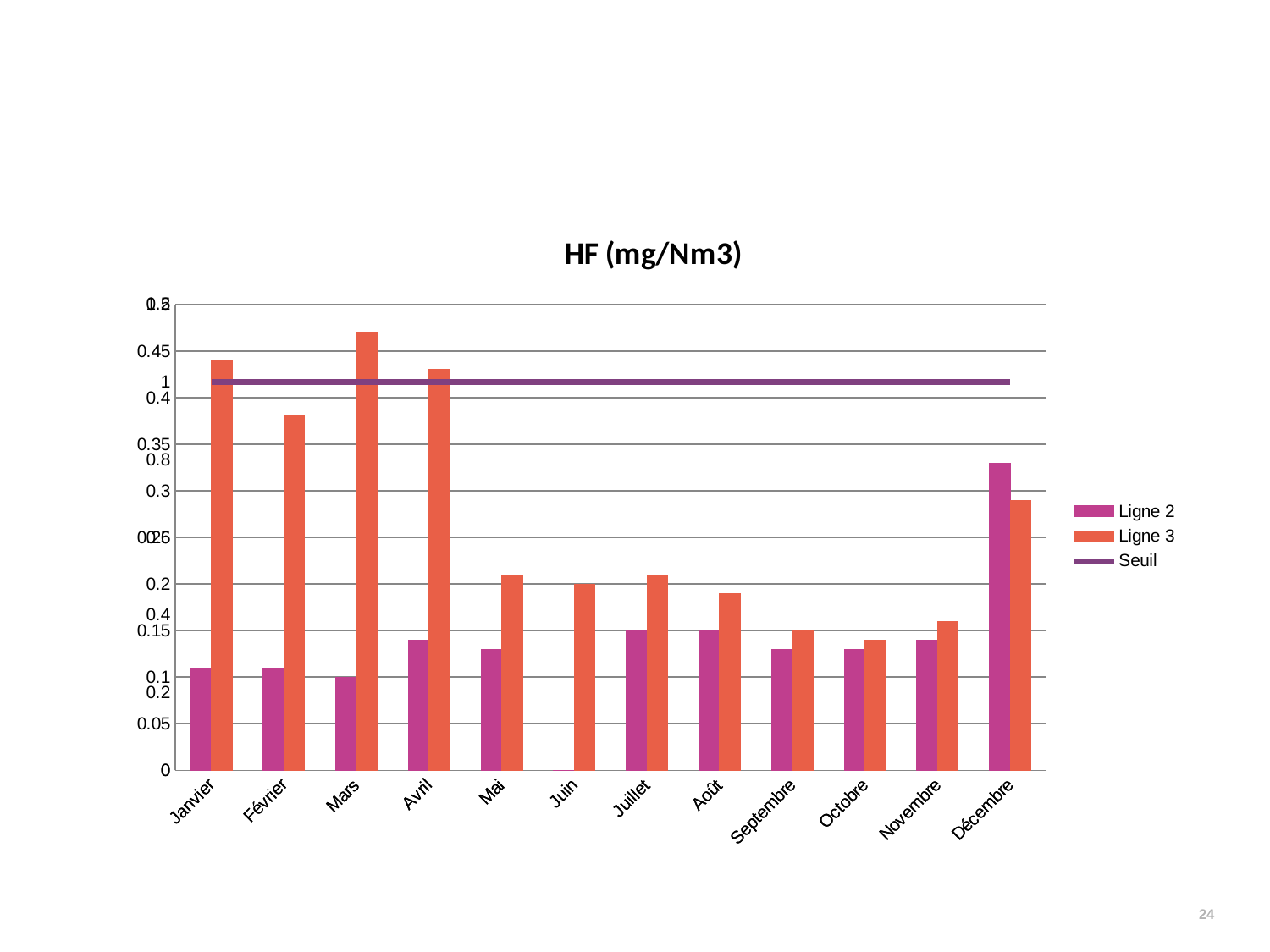
Do the Ligne 3 values rise or fall from Mars to Juin? fall Which legend entry is drawn as a horizontal line rather than bars? Seuil In Décembre, which is larger, Ligne 2 or Ligne 3? Ligne 2 What is the title of the chart? HF (mg/Nm3) How many months are shown on the x axis? 12 What type of chart is shown on the slide? combination bar and line chart In Janvier, which is larger, Ligne 2 or Ligne 3? Ligne 3 For Ligne 3, which is larger, Mars or Avril? Mars Which month has the highest Ligne 3 value? Mars How many series does the legend list? 3 Which month has the highest Ligne 2 value? Décembre